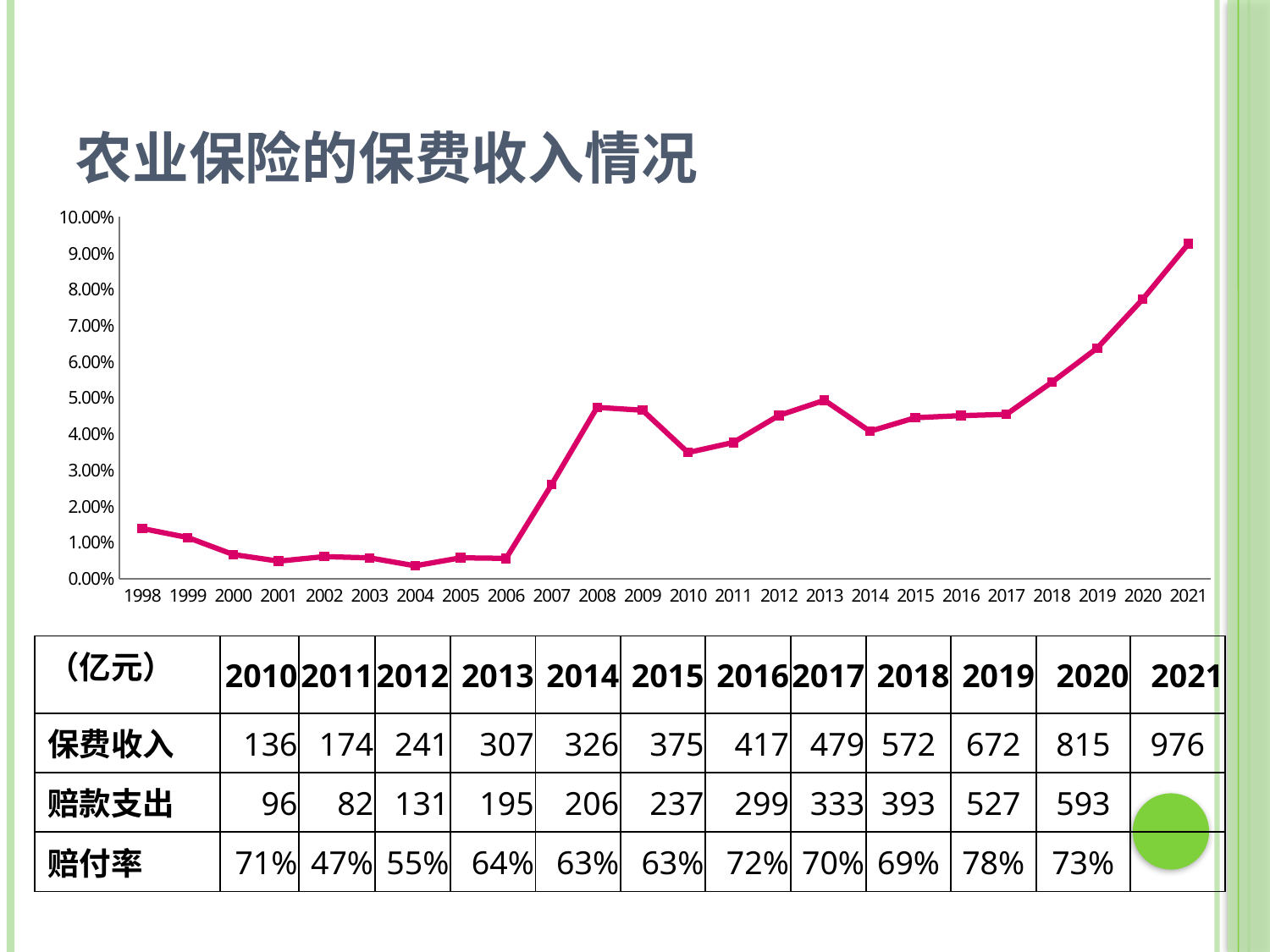
Which year has the larger value on the line chart, 2007 or 2008? 2008 How many years are plotted along the x axis of the line chart? 24 Is the value for 2020 greater or less than 7.00%? greater What kind of chart is shown on the slide? line chart Is the value for 2008 greater or less than 4.00%? greater Which year has the lowest value on the line chart? 2004 Do the values on the line chart rise or fall from 2017 to 2021? rise What is the title of the slide containing the chart? 农业保险的保费收入情况 Is the value for 2004 greater or less than 1.00%? less Which year has the highest value on the line chart? 2021